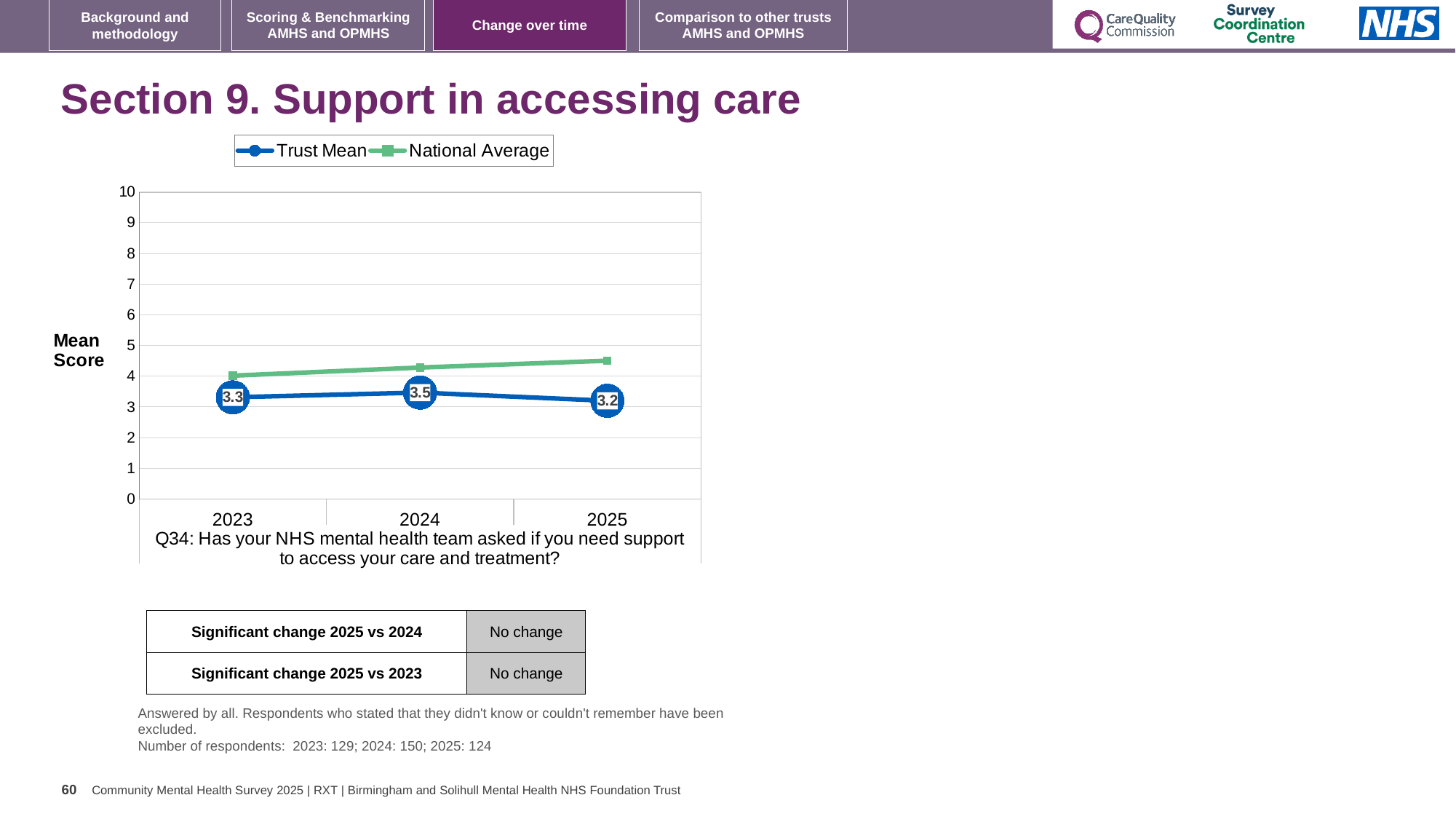
Is the National Average value for 2025 greater or less than 4? greater What is the difference between the Trust Mean in 2024 and in 2025? 0.3 How many years are plotted on the x axis? 3 In which year is the Trust Mean highest? 2024 What is the Trust Mean score for 2023? 3.3 Which is larger in 2025, the Trust Mean or the National Average? National Average What kind of chart is shown on the slide? Line chart Is the Trust Mean value for 2023 greater or less than 4? less What is the Trust Mean score for 2024? 3.5 How many series does the legend list? 2 In which year is the Trust Mean lowest? 2025 What is the Trust Mean score for 2025? 3.2